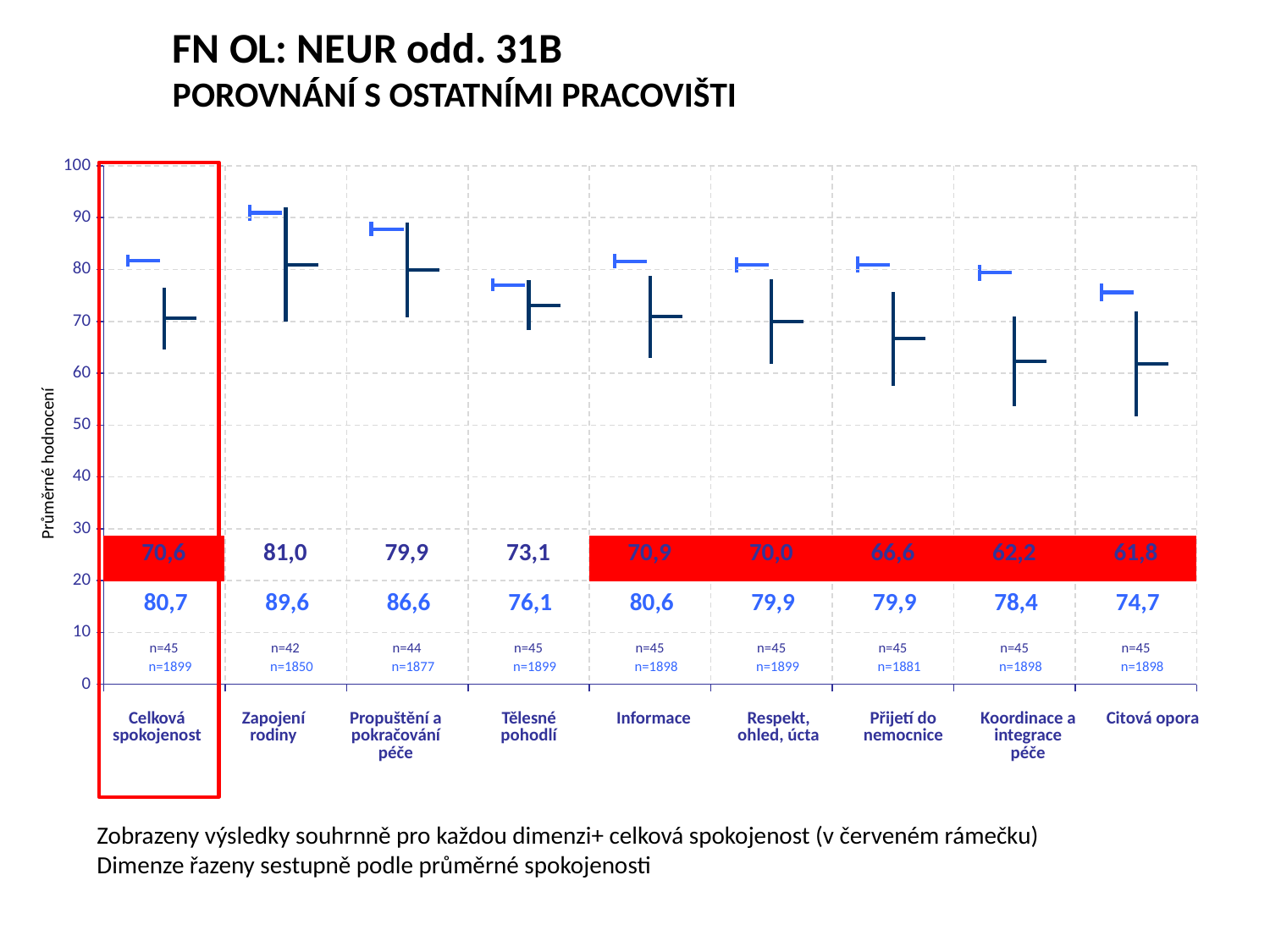
What is the difference between the light-blue and dark-blue values for Přijetí do nemocnice? 13,3 Is the dark-blue value for Koordinace a integrace péče greater or less than 70? less What is the label of the y axis? Průměrné hodnocení How many dimensions (categories) are shown on the x axis? 9 What is the light-blue value printed for Koordinace a integrace péče? 78,4 Which dimension has the highest dark-blue (department) value? Zapojení rodiny Which dimension has the lowest dark-blue (department) value? Citová opora What is the dark-blue value printed for Citová opora? 61,8 Which is larger for Tělesné pohodlí: the dark-blue value or the light-blue value? the light-blue value (76,1) What is the light-blue (comparison) value printed for Celková spokojenost? 80,7 What is the dark-blue (department) value printed for Zapojení rodiny? 81,0 What is the n value printed in the first line for Zapojení rodiny? n=42